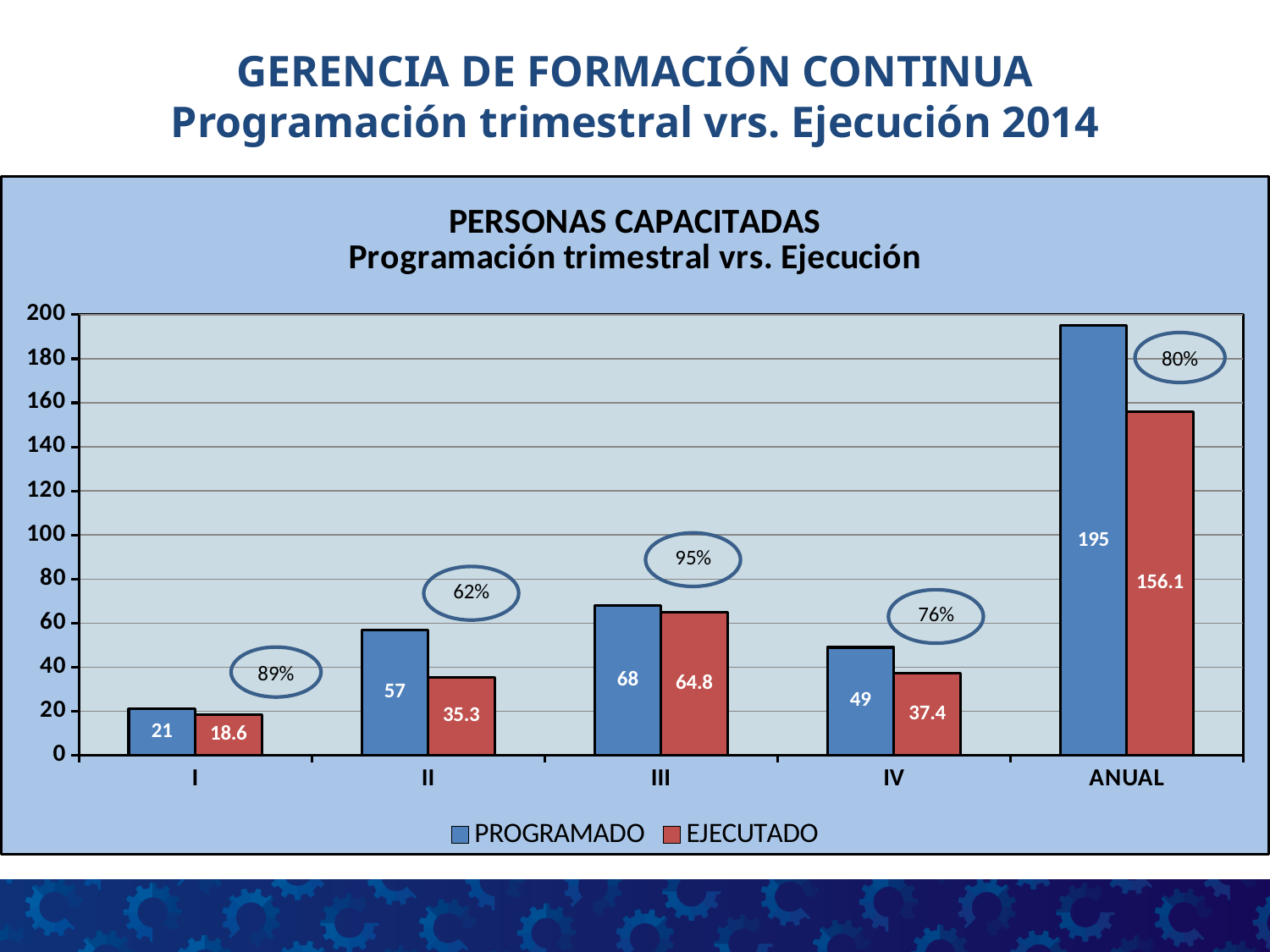
Which is larger for quarter II: PROGRAMADO or EJECUTADO? PROGRAMADO How many series does the legend list? 2 Which category has the highest PROGRAMADO value? ANUAL What is the difference between PROGRAMADO and EJECUTADO for quarter IV? 11.6 Which category has the lowest EJECUTADO value? I What percentage is shown in the circle above quarter III? 95% What is the EJECUTADO value for ANUAL? 156.1 What is the PROGRAMADO value for quarter II? 57 How many categories are shown on the x axis? 5 What colour are the EJECUTADO bars? Red What kind of chart is shown? Bar chart What is the EJECUTADO value for quarter III? 64.8